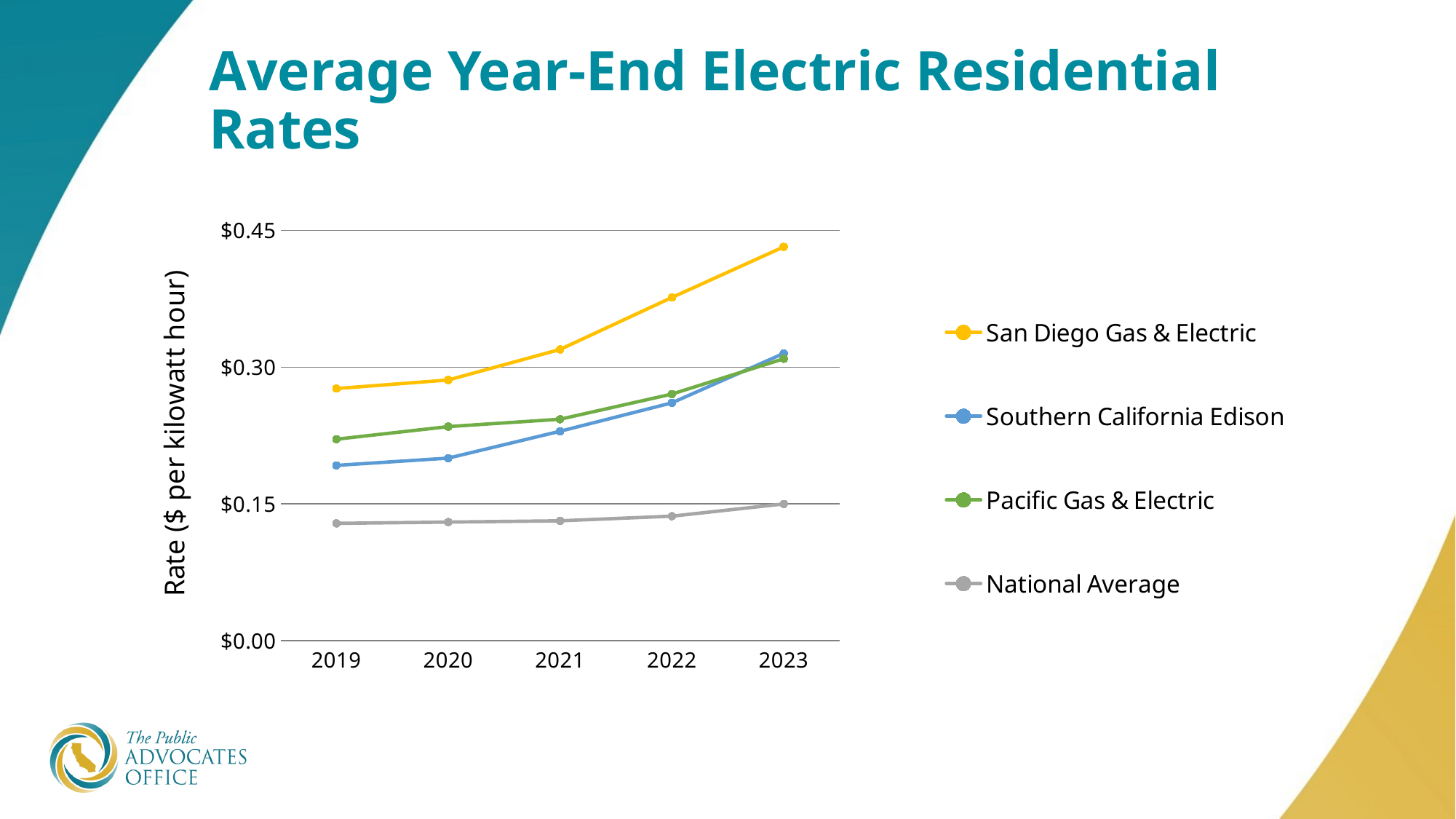
Which series has the highest rate in 2023? San Diego Gas & Electric In 2019, which is higher: Pacific Gas & Electric or Southern California Edison? Pacific Gas & Electric Is the value for San Diego Gas & Electric in 2023 greater or less than $0.45? less Is the value for San Diego Gas & Electric in 2022 greater or less than $0.30? greater How many years are plotted along the x axis? 5 What kind of chart is shown on the slide? line chart How many series does the legend list? 4 What is the label of the y axis? Rate ($ per kilowatt hour) Which series has the lowest rate in 2023? National Average Is the value for National Average in 2019 greater or less than $0.15? less Does the San Diego Gas & Electric rate rise or fall from 2019 to 2023? rise